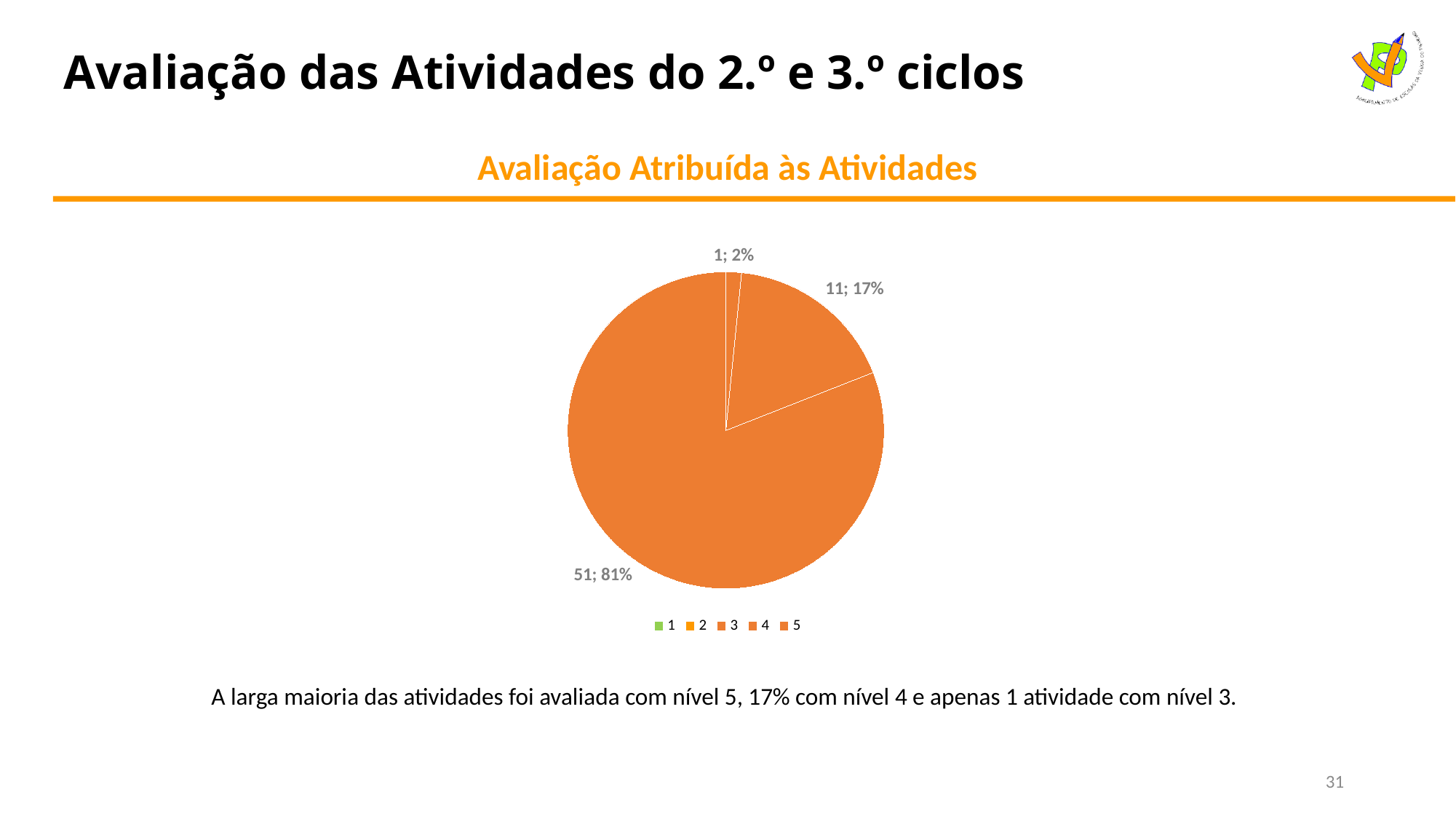
What share of the pie does the largest slice represent? 81% What share of the pie does the slice with 11 activities represent? 17% What is the total number of activities across the three labelled slices? 63 What kind of chart is shown on the slide? pie chart What is the title of the chart? Avaliação Atribuída às Atividades Which is larger: the slice labelled 11; 17% or the slice labelled 1; 2%? 11; 17% According to the slide, how many activities were rated with level 4? 11 How many slices of the pie have data labels? 3 What is the difference in number of activities between the largest slice (51) and the slice with 11 activities? 40 How many entries does the chart's legend list? 5 What is the data label of the largest slice of the pie? 51; 81% What is the data label of the smallest slice of the pie? 1; 2%